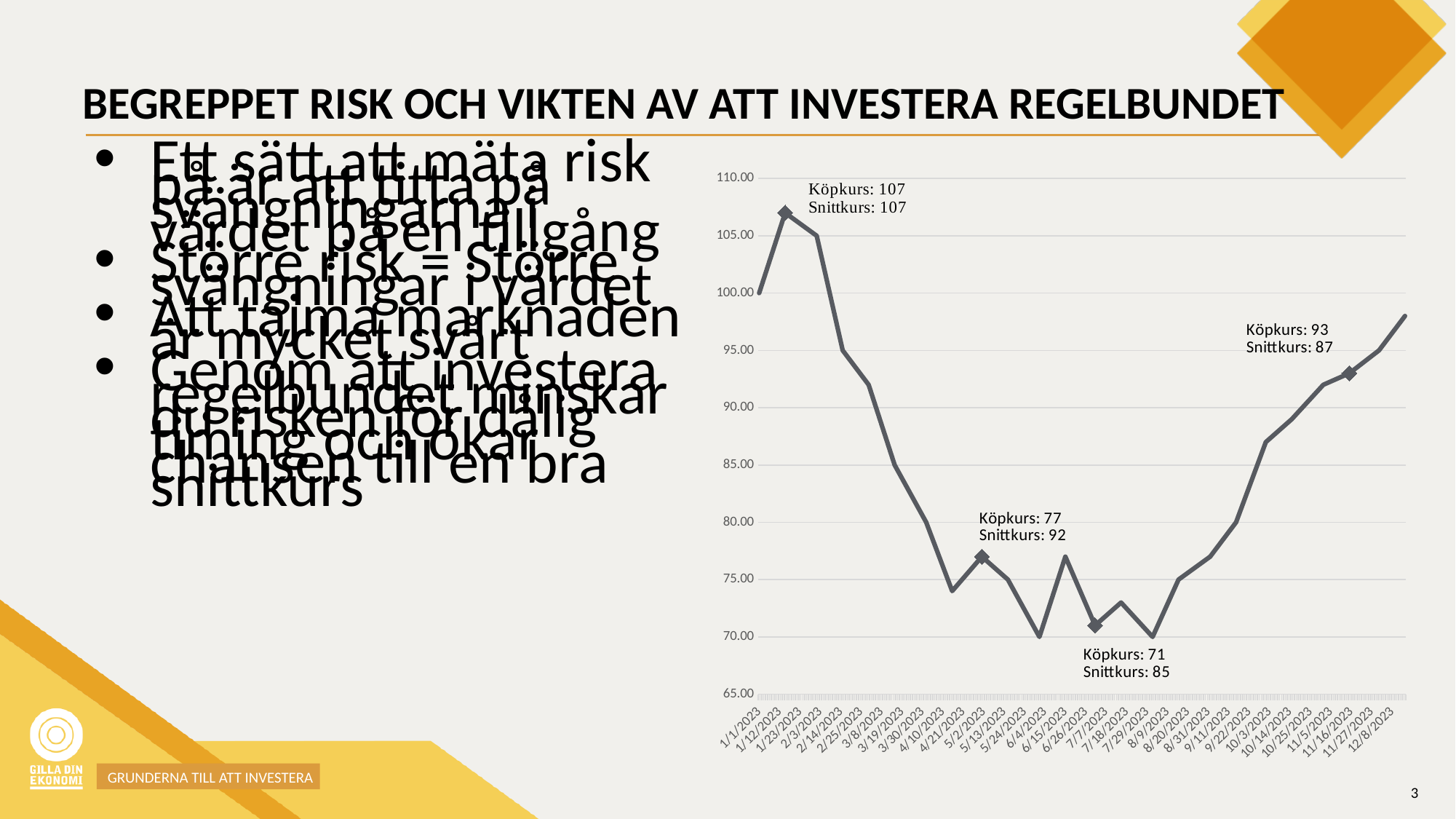
Is the value around 4/21/2023 greater or less than 75? less What is the difference between the highest annotated Köpkurs (107) and the lowest annotated Köpkurs (71)? 36 Which annotated point has the highest Köpkurs? Köpkurs: 107 (around 1/23/2023) What is the Köpkurs shown at the annotated point around 7/7/2023? 71 What is the Snittkurs shown at the annotated point around 5/13/2023? 92 What is the Köpkurs shown at the first annotated point (around 1/23/2023)? 107 What kind of chart is shown on the slide? line chart How many annotated Köpkurs/Snittkurs points are marked on the line? 4 At the annotated point around 11/16/2023, which is larger, the Köpkurs or the Snittkurs? Köpkurs Is the value at the last date (12/8/2023) greater or less than 95? greater Which annotated point has the lowest Köpkurs? Köpkurs: 71 (around 7/7/2023) What is the Snittkurs shown at the annotated point around 11/16/2023? 87